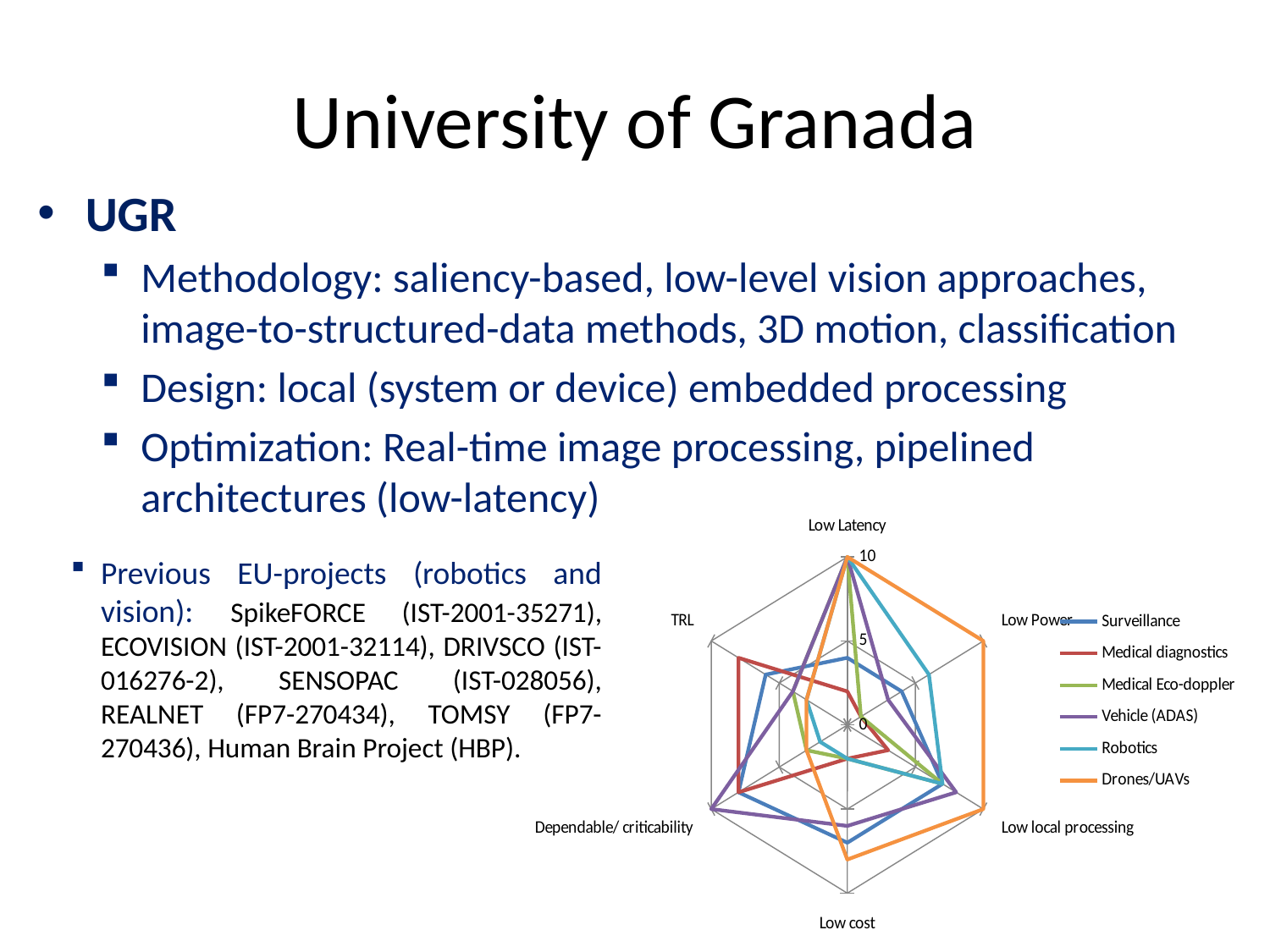
What is the value for Drones/UAVs on the Low Latency axis? 10 Is the value for Drones/UAVs on the Low cost axis greater or less than 5? greater Which series is drawn in orange in the legend? Drones/UAVs What kind of chart is shown on the slide? Radar chart Is the value for Medical diagnostics on the Dependable/ criticability axis greater or less than 5? greater What is the maximum value shown on the chart's axis scale? 10 Is the value for Medical diagnostics on the Low Latency axis greater or less than 5? less How many series does the chart's legend list? 6 How many axes (categories) does the radar chart have? 6 Which series is larger on the Low Power axis, Drones/UAVs or Medical diagnostics? Drones/UAVs What is the value for Drones/UAVs on the Low Power axis? 10 What is the value for Vehicle (ADAS) on the Dependable/ criticability axis? 10